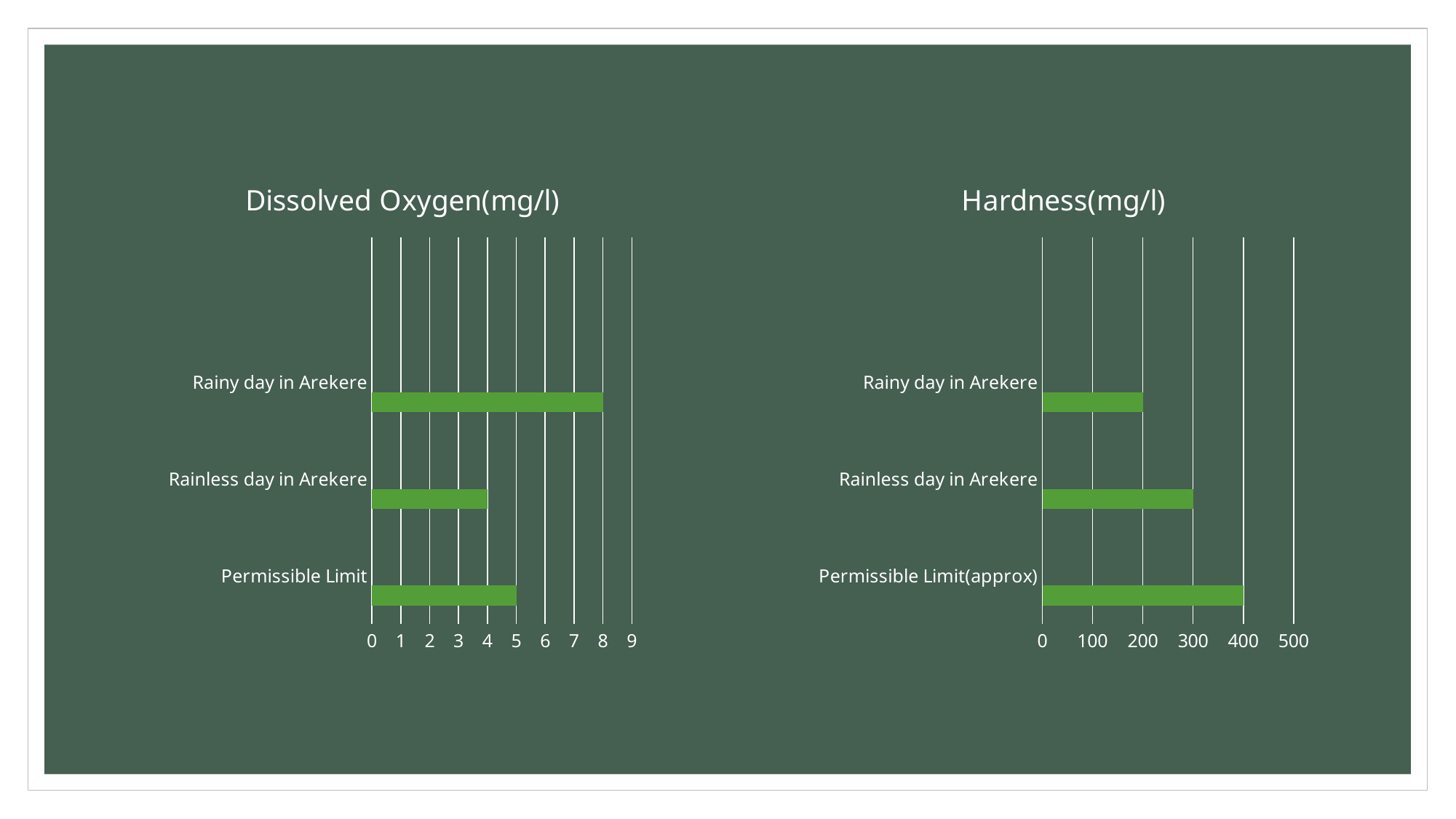
In the Hardness(mg/l) chart, what is the value for Permissible Limit(approx)? 400 In the Dissolved Oxygen(mg/l) chart, which category has the lowest value? Rainless day in Arekere In the Dissolved Oxygen(mg/l) chart, what is the value for Rainy day in Arekere? 8 In the Dissolved Oxygen(mg/l) chart, what is the difference between Rainy day in Arekere and Rainless day in Arekere? 4 In the Hardness(mg/l) chart, which category has the highest value? Permissible Limit(approx) What type of chart is the Hardness(mg/l) chart? Bar chart In the Dissolved Oxygen(mg/l) chart, which category has the highest value? Rainy day in Arekere In the Hardness(mg/l) chart, which is larger: Rainless day in Arekere or Rainy day in Arekere? Rainless day in Arekere In the Hardness(mg/l) chart, what is the difference between Permissible Limit(approx) and Rainless day in Arekere? 100 In the Hardness(mg/l) chart, what is the value for Rainy day in Arekere? 200 In the Dissolved Oxygen(mg/l) chart, what is the value for Rainless day in Arekere? 4 In the Dissolved Oxygen(mg/l) chart, what is the value for Permissible Limit? 5